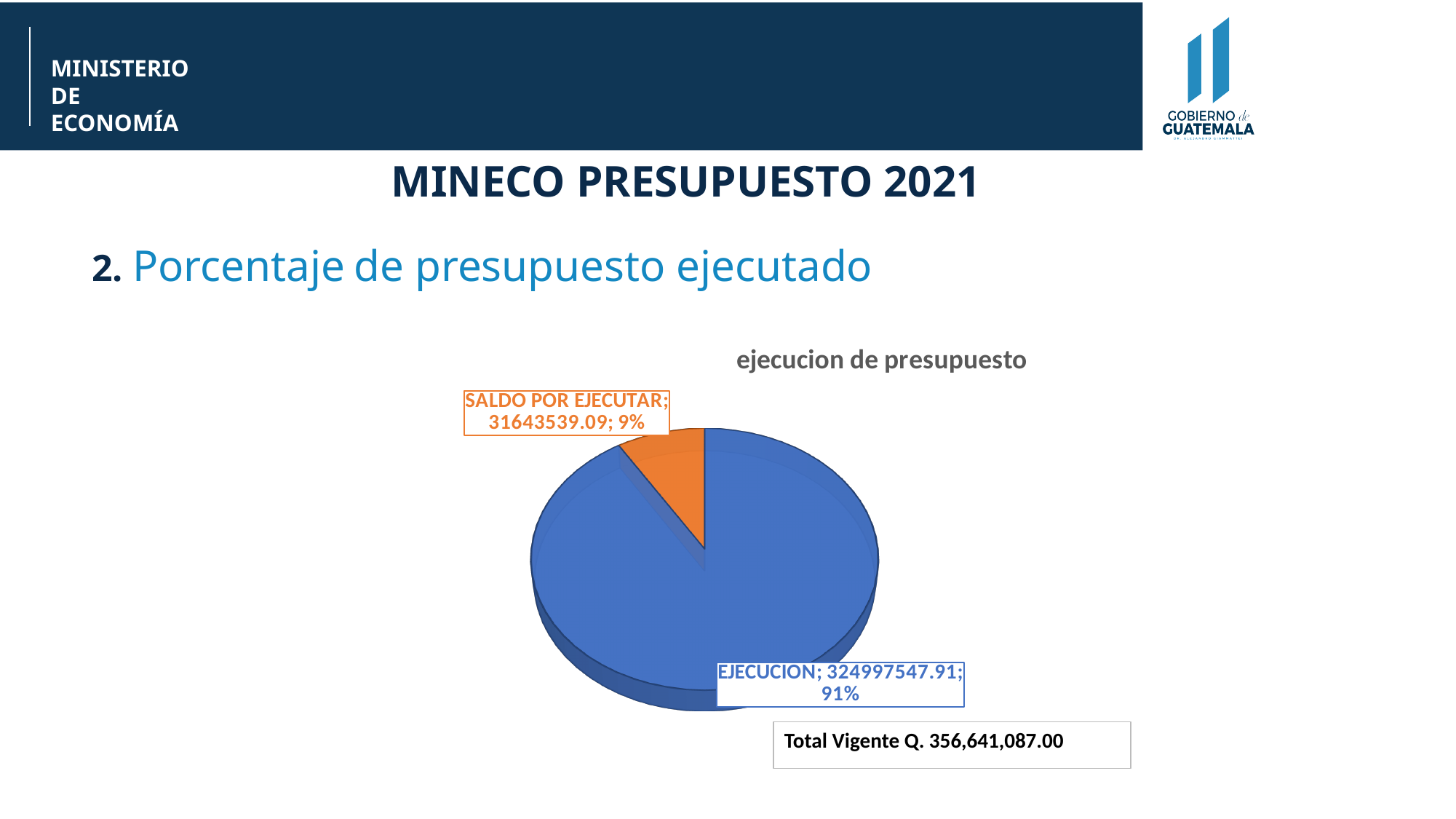
What percentage share of the pie does SALDO POR EJECUTAR represent? 9% Which is larger, EJECUCION or SALDO POR EJECUTAR? EJECUCION Which slice is the largest in the pie chart? EJECUCION What kind of chart is shown on the slide? pie chart Which slice is the smallest in the pie chart? SALDO POR EJECUTAR What is the value shown for SALDO POR EJECUTAR? 31643539.09 What is the value shown for EJECUCION? 324997547.91 What colour is the SALDO POR EJECUTAR slice? orange How many slices does the pie chart have? 2 What is the difference between the EJECUCION value and the SALDO POR EJECUTAR value? 293354008.82 What percentage share of the pie does EJECUCION represent? 91% What is the title of the chart? ejecucion de presupuesto